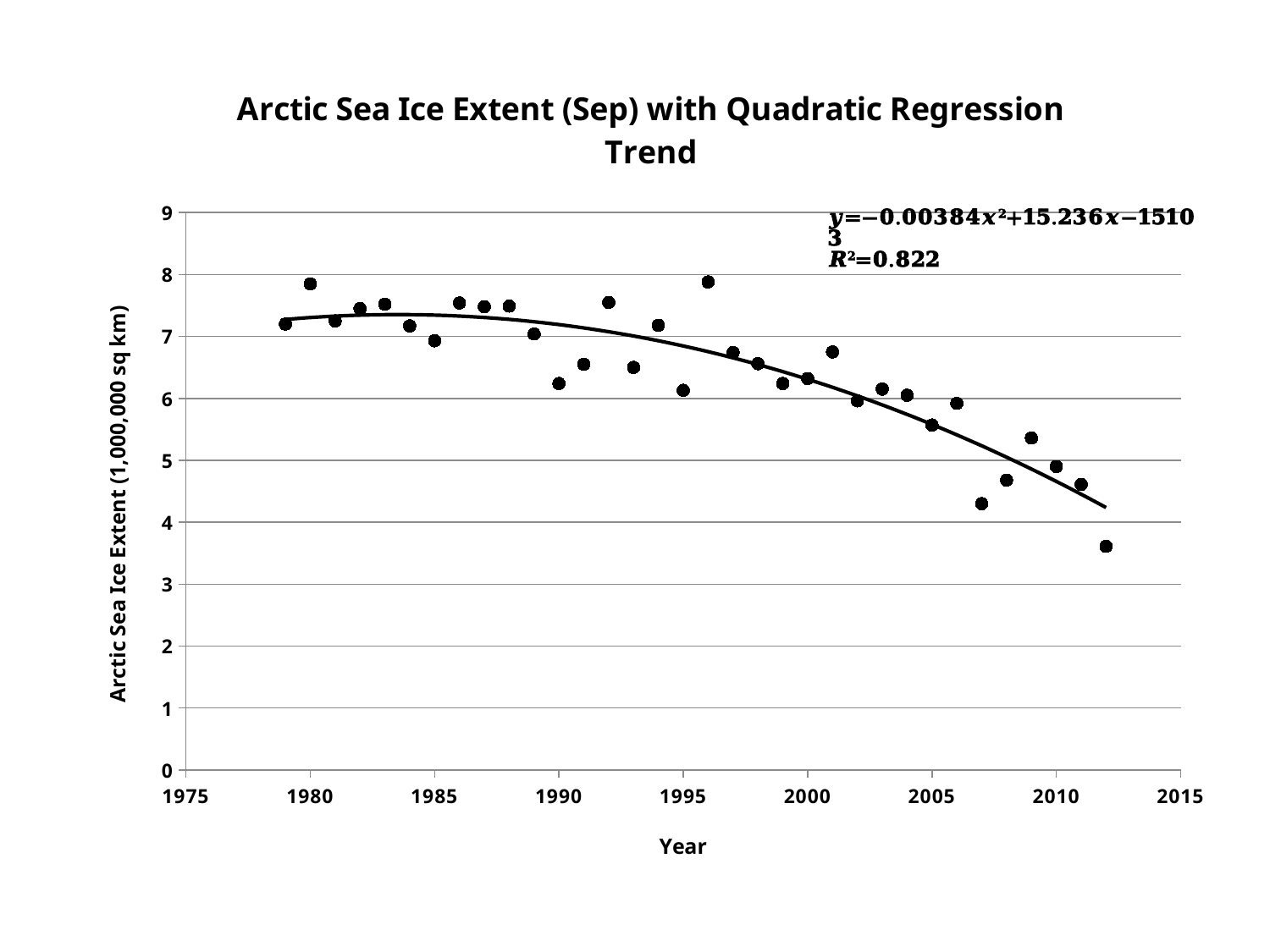
Overall, do the values rise or fall as the year increases along the x axis? fall What kind of chart is shown on the slide? scatter plot What is the title of the chart? Arctic Sea Ice Extent (Sep) with Quadratic Regression Trend What is the R² value shown for the quadratic regression? 0.822 Is the value for 2012 greater or less than 4? less Which year has the larger sea ice extent, 2007 or 2009? 2009 Is the value for 1996 greater or less than 7? greater Is the value for 1980 greater or less than 7? greater Which year has the lowest Arctic sea ice extent on the chart? 2012 Which year has the larger sea ice extent, 1979 or 2012? 1979